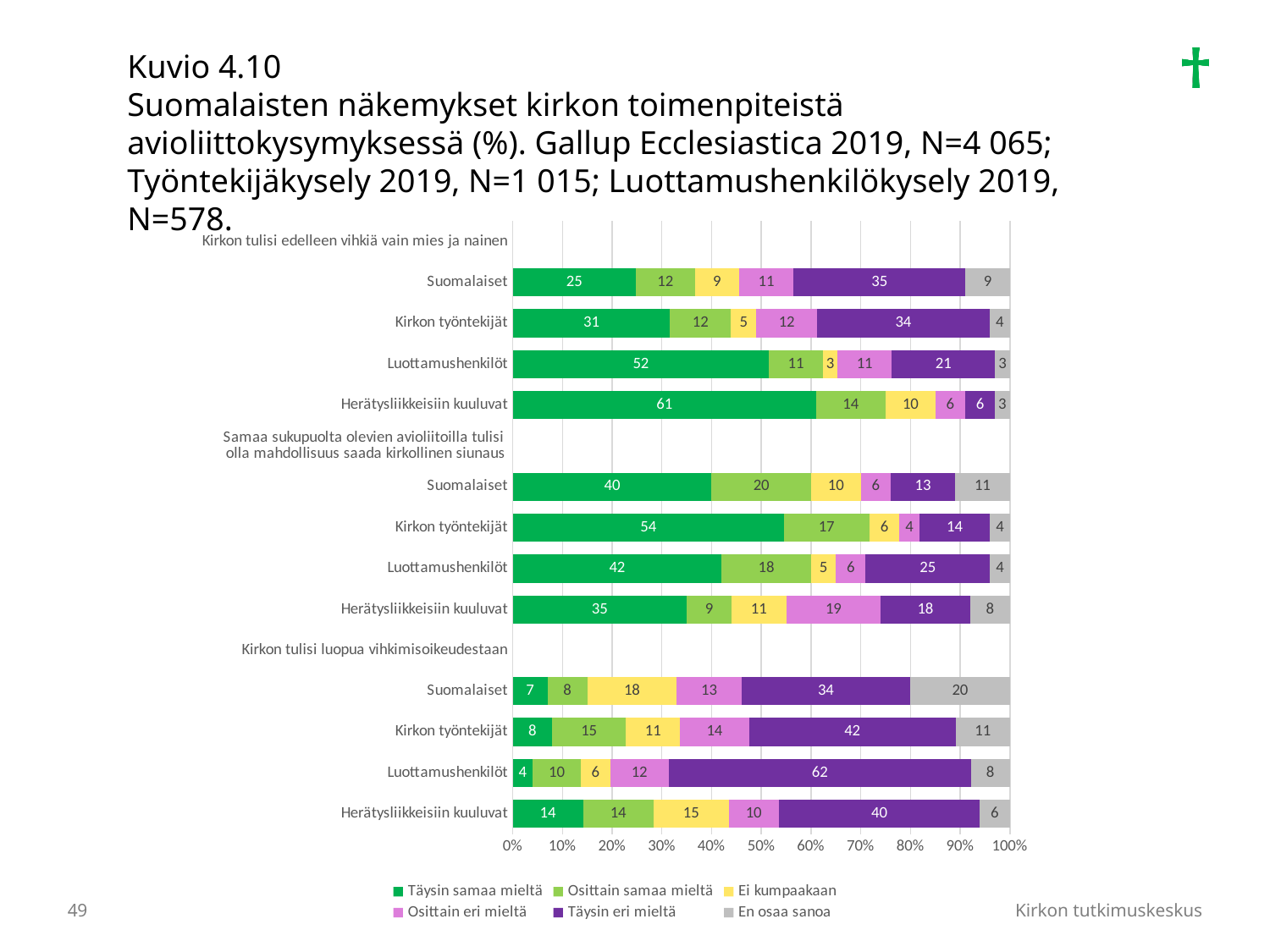
Under 'Kirkon tulisi luopua vihkimisoikeudestaan', what is the 'Täysin eri mieltä' value for Luottamushenkilöt? 62 Under 'Samaa sukupuolta olevien avioliitoilla tulisi olla mahdollisuus saada kirkollinen siunaus', what is the difference between the 'Täysin samaa mieltä' values for Kirkon työntekijät and Herätysliikkeisiin kuuluvat? 19 How many series does the legend list? 6 Under 'Kirkon tulisi luopua vihkimisoikeudestaan', what is the 'En osaa sanoa' value for Suomalaiset? 20 What type of chart is shown on the slide? Stacked bar chart How many bars (respondent groups) are plotted in the chart in total? 12 Which legend entry is shown in grey? En osaa sanoa Under 'Kirkon tulisi edelleen vihkiä vain mies ja nainen', which group has the highest 'Täysin samaa mieltä' value? Herätysliikkeisiin kuuluvat Under 'Samaa sukupuolta olevien avioliitoilla tulisi olla mahdollisuus saada kirkollinen siunaus', what is the 'Osittain samaa mieltä' value for Suomalaiset? 20 Under 'Kirkon tulisi edelleen vihkiä vain mies ja nainen', which is larger: the 'Täysin eri mieltä' value for Suomalaiset or for Luottamushenkilöt? Suomalaiset Under 'Kirkon tulisi edelleen vihkiä vain mies ja nainen', what is the 'Täysin samaa mieltä' value for Herätysliikkeisiin kuuluvat? 61 Under 'Kirkon tulisi luopua vihkimisoikeudestaan', which group has the lowest 'Täysin samaa mieltä' value? Luottamushenkilöt